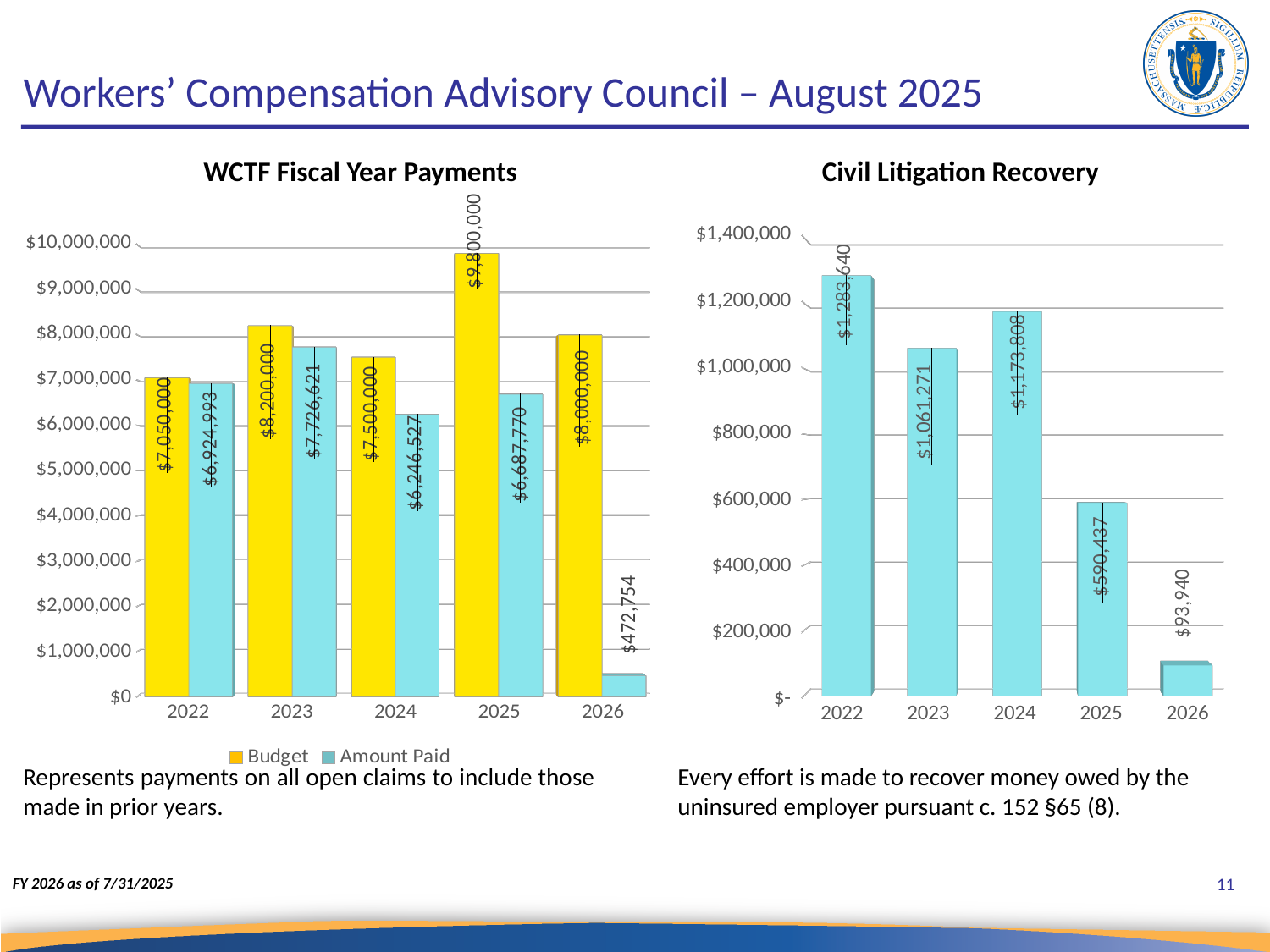
In the WCTF Fiscal Year Payments chart, which year has the highest Budget? 2025 In the WCTF Fiscal Year Payments chart, what is the Budget value for 2025? $9,800,000 In the WCTF Fiscal Year Payments chart, what is the Amount Paid for 2023? $7,726,621 In the Civil Litigation Recovery chart, what is the value for 2024? $1,173,808 How many series does the legend of the WCTF Fiscal Year Payments chart list? 2 How many years are shown on the x axis of the Civil Litigation Recovery chart? 5 What kind of chart is the Civil Litigation Recovery chart? Bar chart In the WCTF Fiscal Year Payments chart, which is larger for 2024: the Budget or the Amount Paid? Budget In the Civil Litigation Recovery chart, what is the difference between the 2022 and 2023 values? $222,369 In the WCTF Fiscal Year Payments chart, what is the difference between the Budget and the Amount Paid for 2025? $3,112,230 In the Civil Litigation Recovery chart, which year has the highest recovery? 2022 In the WCTF Fiscal Year Payments chart, which year has the lowest Amount Paid? 2026